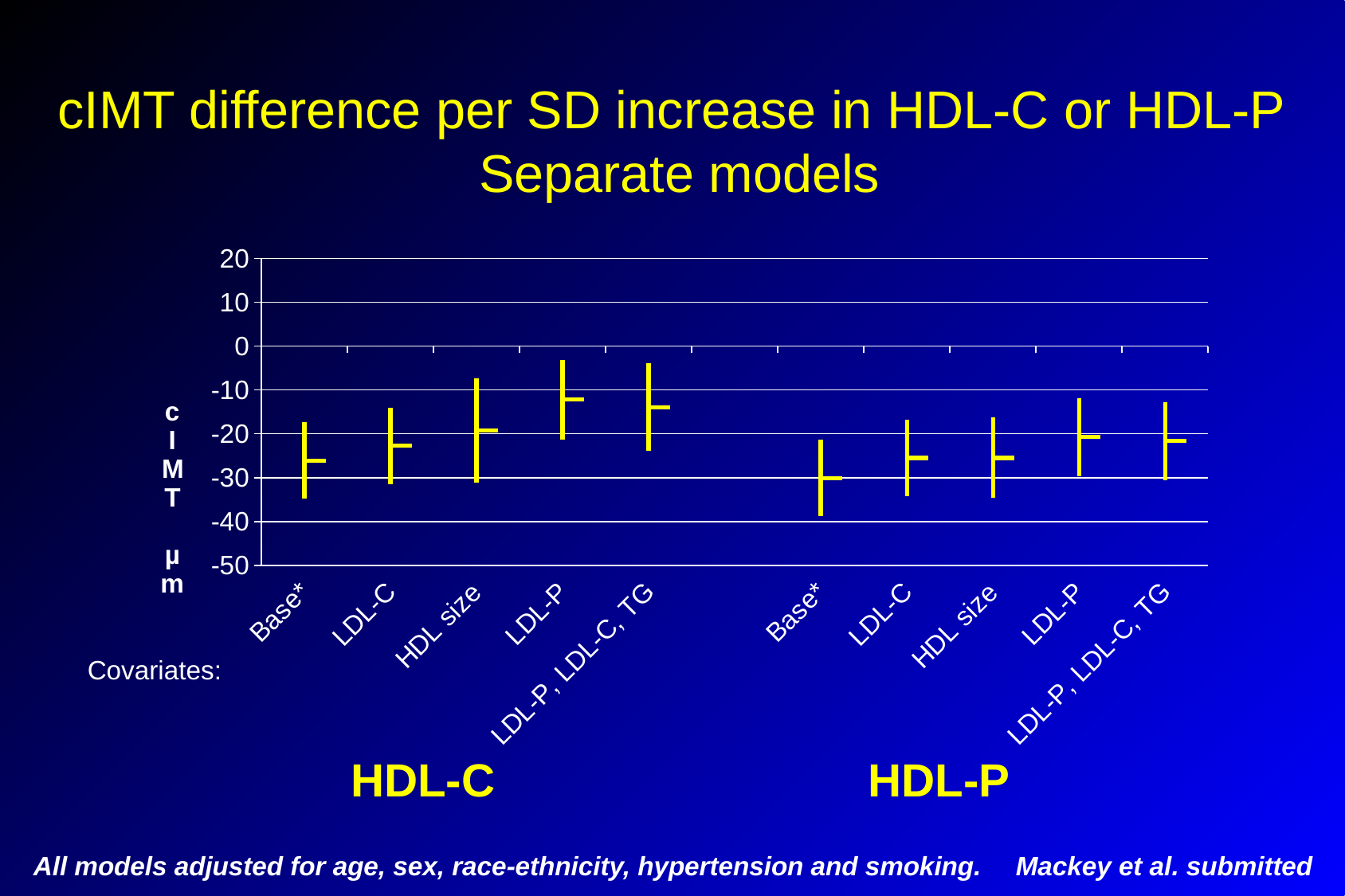
How many covariate categories are plotted for the HDL-C group? 5 What unit is given on the y axis label? µm In the HDL-C group, do the point estimates rise or fall from Base* to LDL-P? rise In the HDL-P group, which has the larger point estimate: Base* or LDL-P? LDL-P What are the two group labels printed below the x axis? HDL-C and HDL-P Which covariate category has the lowest point estimate on the whole chart? Base* in the HDL-P group Is the point estimate for LDL-P in the HDL-P group greater or less than -30? greater Is the point estimate for Base* in the HDL-C group greater or less than -20? less Is the point estimate for Base* in the HDL-P group greater or less than -20? less How many covariate categories are shown on the x axis in total across both groups? 10 In the HDL-C group, which has the larger point estimate: Base* or LDL-P? LDL-P